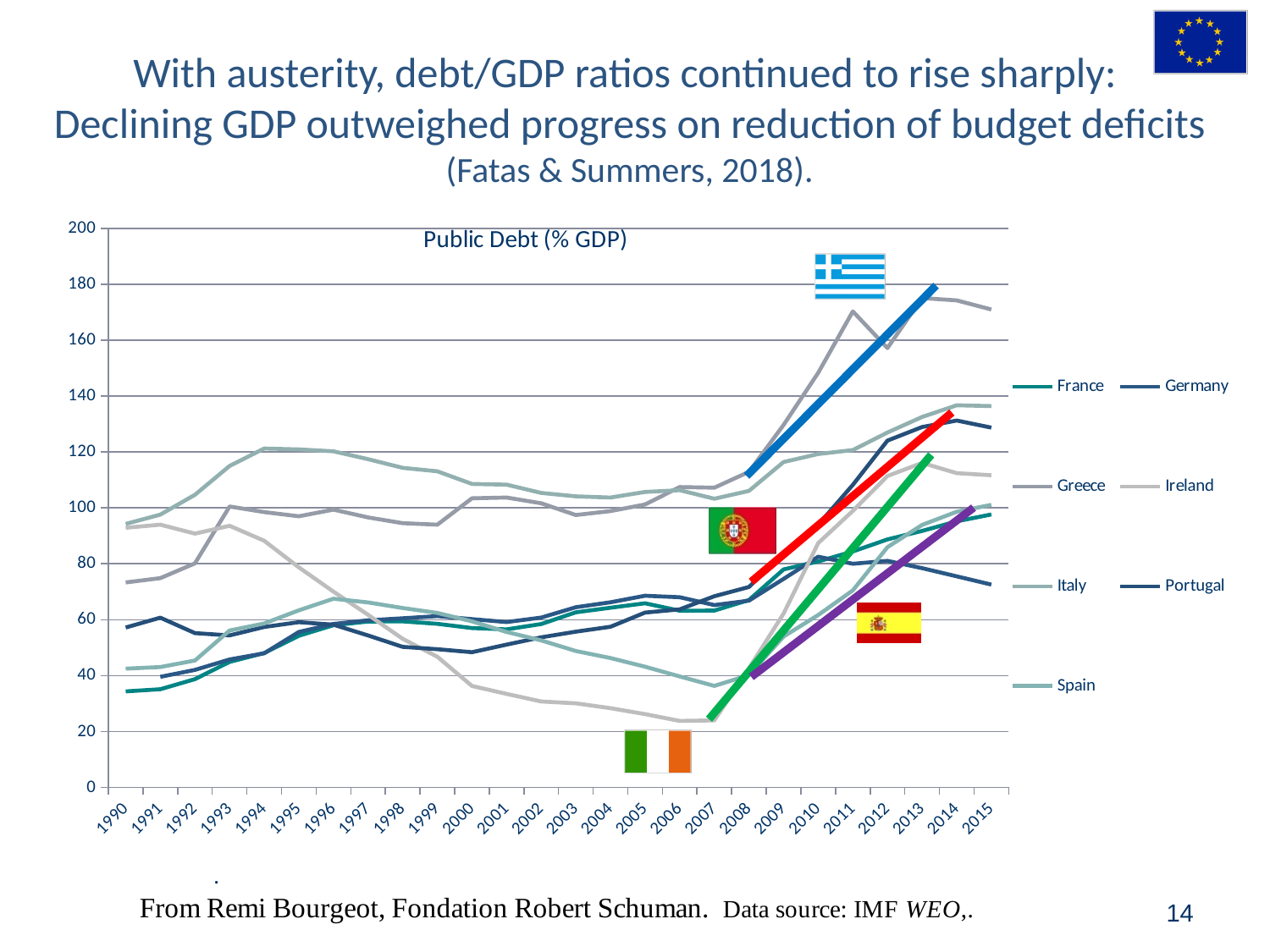
Which country has the lowest public debt (% GDP) in 2007? Ireland Is the value for Greece in 2011 greater or less than 160? greater Is the value for Ireland in 2007 greater or less than 40? less Which country has the lowest public debt (% GDP) in 2015? Germany What kind of chart is shown on the slide? line chart How many series does the chart legend list? 7 Which country has the highest public debt (% GDP) in 2015? Greece Which country has the highest public debt (% GDP) in 1990? Italy Which is larger in 2015, the value for Italy or the value for Germany? Italy What is the title of the chart? Public Debt (% GDP) Does the value for Greece rise or fall from 2008 to 2011? rise How many years are shown along the x axis of the chart? 26